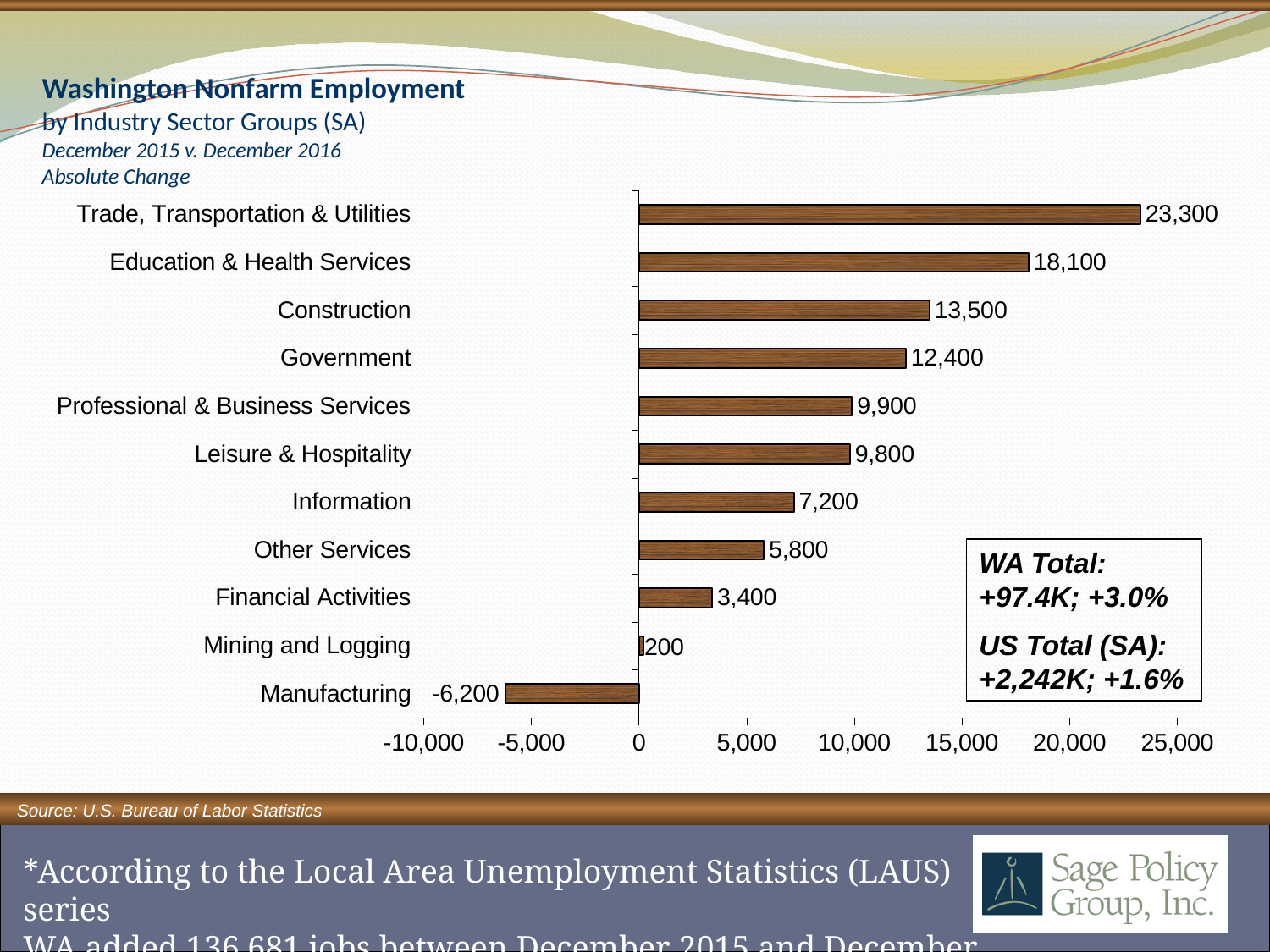
What is the absolute change in employment for Mining and Logging? 200 Which has a larger absolute change, Government or Information? Government What kind of chart is shown on the slide? Bar chart What is the absolute change in employment for Manufacturing? -6,200 What is the absolute change in employment for Financial Activities? 3,400 What is the WA Total shown in the text box on the chart? +97.4K; +3.0% How many industry sector groups are shown in the chart? 11 Which industry sector group has the lowest absolute change? Manufacturing Is the value for Education & Health Services greater or less than 15,000? greater What is the difference between the absolute change for Trade, Transportation & Utilities and Education & Health Services? 5,200 What is the absolute change in employment for Construction? 13,500 Which industry sector group has the largest absolute change? Trade, Transportation & Utilities